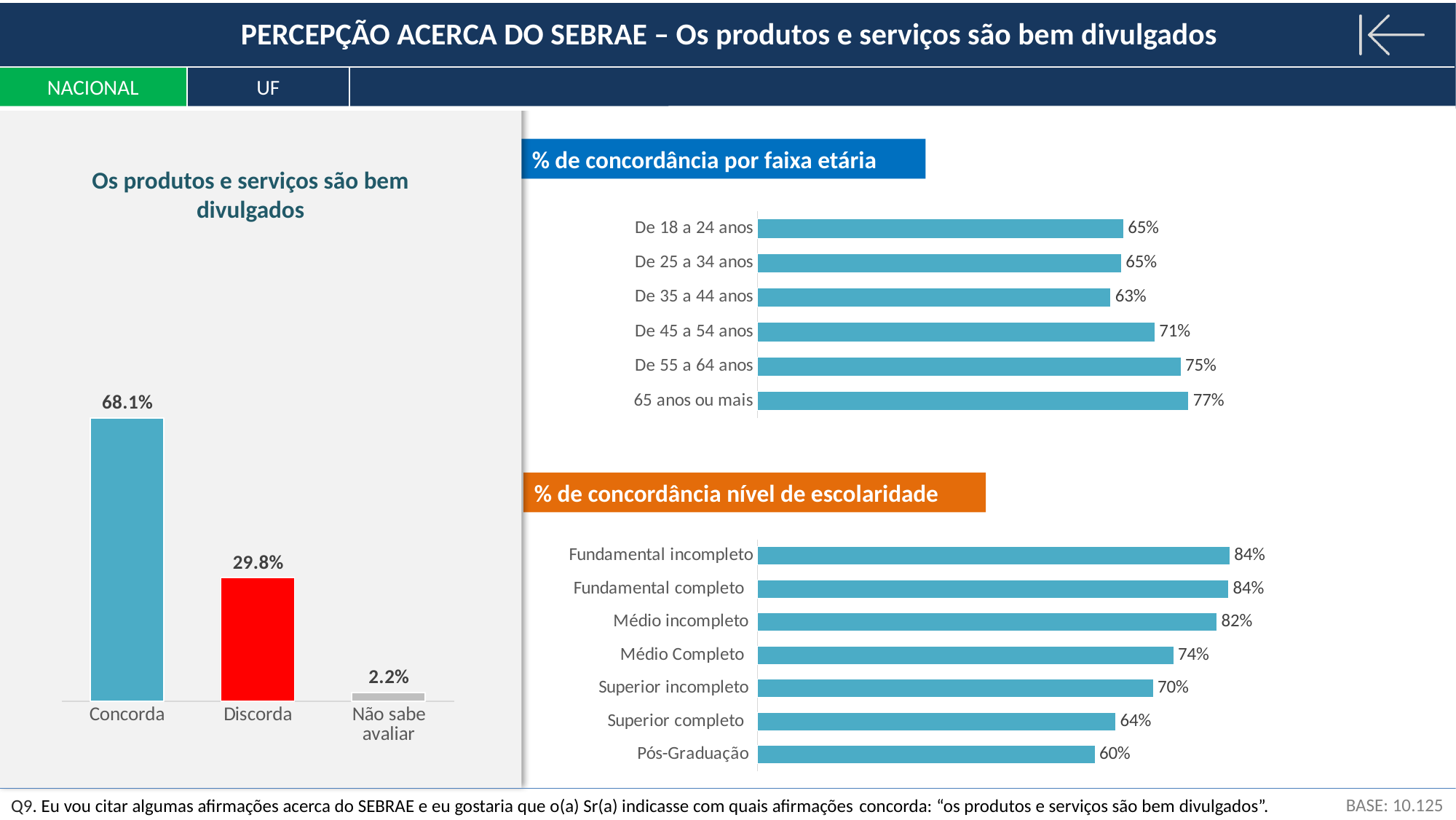
In the chart '% de concordância nível de escolaridade', how many education levels are shown? 7 In the chart titled 'Os produtos e serviços são bem divulgados', which category has the lowest value? Não sabe avaliar In the chart '% de concordância nível de escolaridade', what is the value for Pós-Graduação? 60% In the chart titled 'Os produtos e serviços são bem divulgados', what is the value for Discorda? 29.8% In the chart '% de concordância nível de escolaridade', what is the difference between Médio incompleto and Superior completo? 18% In the chart '% de concordância por faixa etária', do the values generally rise or fall from the youngest to the oldest age group? rise In the chart '% de concordância por faixa etária', what is the value for De 45 a 54 anos? 71% In the chart titled 'Os produtos e serviços são bem divulgados', how many categories are shown? 3 In the chart titled 'Os produtos e serviços são bem divulgados', what is the value for Concorda? 68.1% In the chart '% de concordância por faixa etária', which age group has the lowest value? De 35 a 44 anos In the chart '% de concordância por faixa etária', which age group has the highest value? 65 anos ou mais In the chart titled 'Os produtos e serviços são bem divulgados', what is the difference between Concorda and Discorda? 38.3%